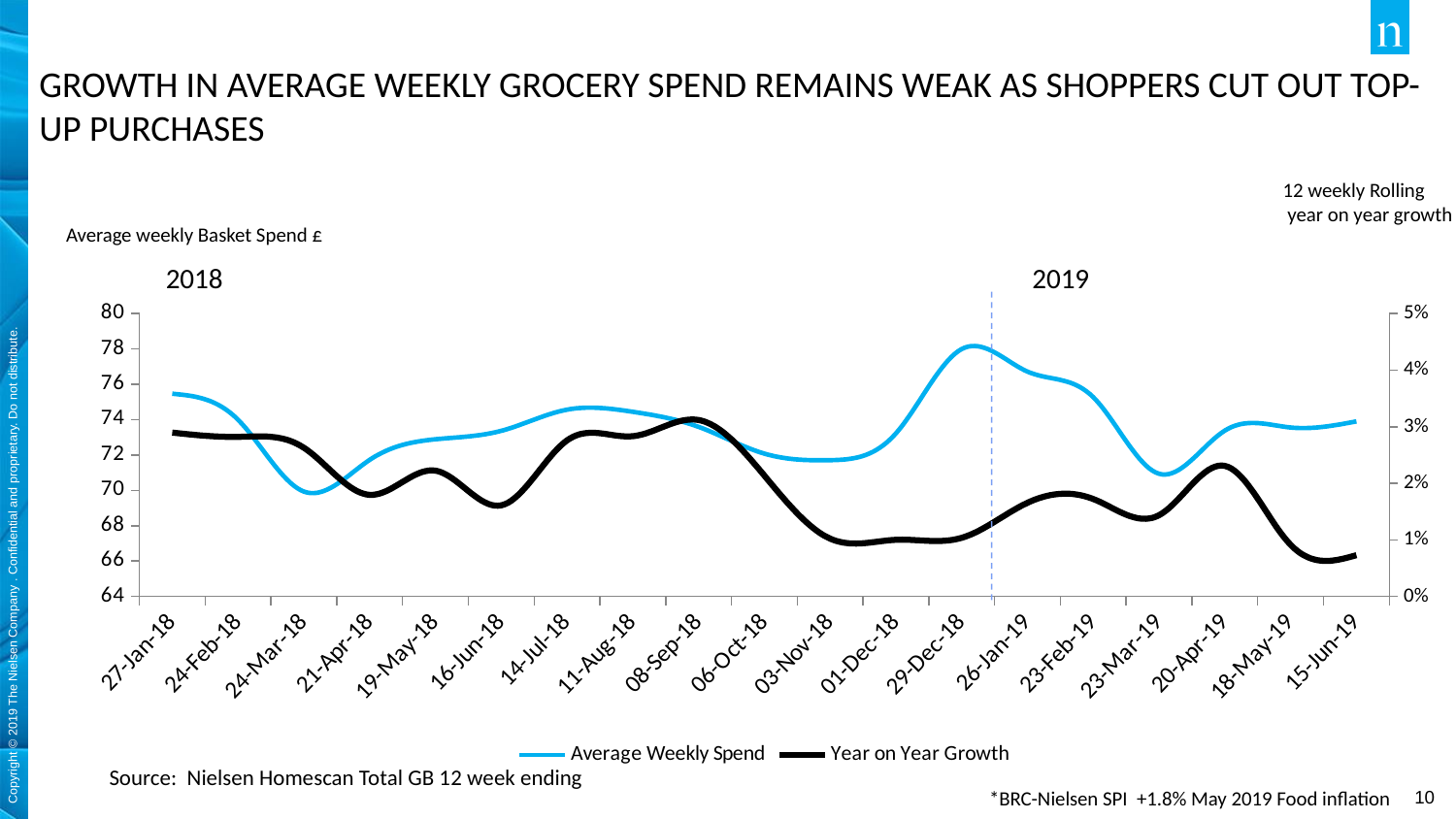
Is the Average Weekly Spend value at 24-Mar-18 greater or less than 72? less At which x-axis date does the Average Weekly Spend line reach its highest point? 29-Dec-18 At which x-axis date does the Average Weekly Spend line reach its lowest point? 24-Mar-18 What is the label of the left-hand vertical axis? Average weekly Basket Spend £ How many date labels are shown along the x axis? 19 Is the Average Weekly Spend value at 29-Dec-18 greater or less than 76? greater Which series is drawn in blue according to the legend? Average Weekly Spend Is the Year on Year Growth value at 27-Jan-18 greater or less than 2%? greater Which is larger, the Year on Year Growth at 08-Sep-18 or at 03-Nov-18? 08-Sep-18 How many series does the legend list? 2 Does the Average Weekly Spend line rise or fall between 29-Dec-18 and 23-Mar-19? Fall What kind of chart is shown on the slide? Line chart